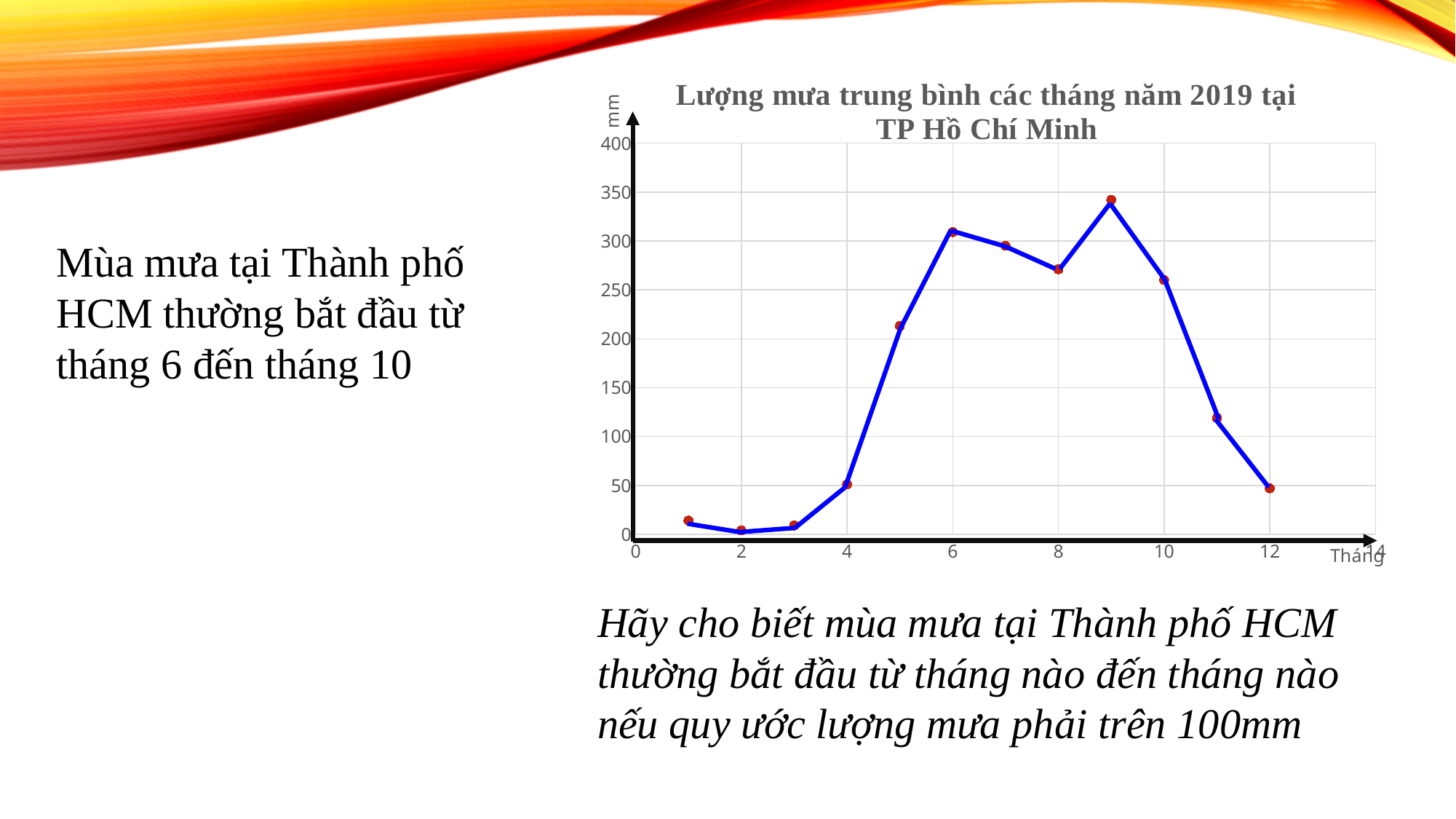
Is the value for month 11 greater or less than 100? greater What is the title of the chart? Lượng mưa trung bình các tháng năm 2019 tại TP Hồ Chí Minh Do the values rise or fall from month 9 to month 12? fall Which month has the highest rainfall value on the chart? 9 Is the value for month 4 greater or less than 100? less What kind of chart is shown on the slide? line chart Which is larger, the value for month 5 or the value for month 10? month 10 Which is larger, the value for month 9 or the value for month 6? month 9 Is the value for month 9 greater or less than 300? greater How many data points are plotted on the line? 12 What unit is shown on the vertical axis of the chart? mm